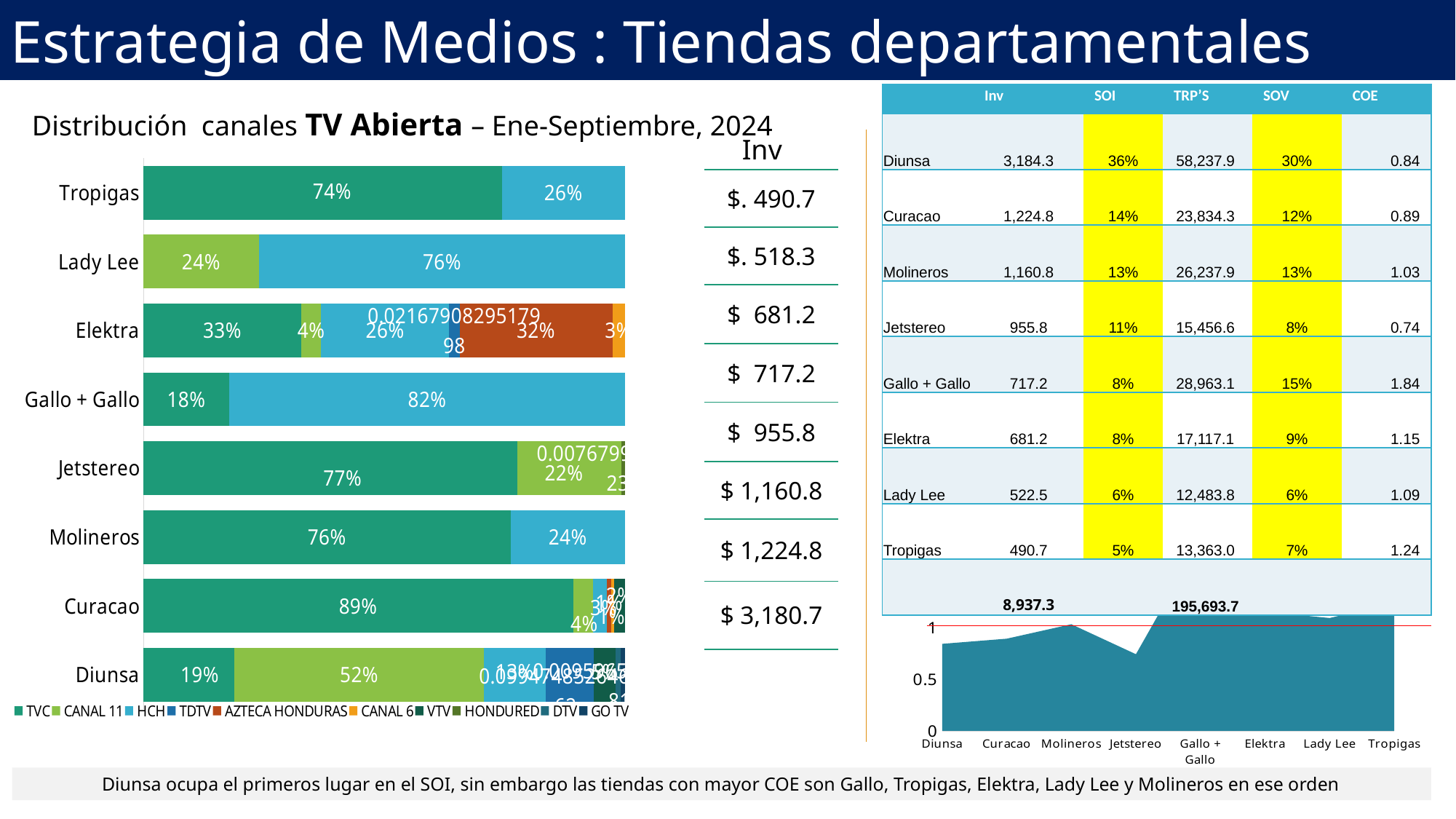
In the 'Distribución canales TV Abierta' chart, what is the difference between the HCH share for Lady Lee and the HCH share for Molineros? 52% In the 'Distribución canales TV Abierta' chart, which store has the highest TVC share? Curacao How many stores are shown in the 'Distribución canales TV Abierta' chart? 8 What kind of chart is the 'Distribución canales TV Abierta' chart? Stacked bar chart In the 'Distribución canales TV Abierta' chart, what share does CANAL 11 have for Diunsa? 52% In the 'Distribución canales TV Abierta' chart, what share does HCH have for Gallo + Gallo? 82% In the area chart at the bottom right of the slide, is the value for Jetstereo greater or less than 1? less In the 'Distribución canales TV Abierta' chart, what share does AZTECA HONDURAS have for Elektra? 32% How many series does the legend of the 'Distribución canales TV Abierta' chart list? 10 In the 'Distribución canales TV Abierta' chart, which is larger: the TVC share for Jetstereo or the TVC share for Molineros? Jetstereo In the 'Distribución canales TV Abierta' chart, what share does TVC have for Tropigas? 74%